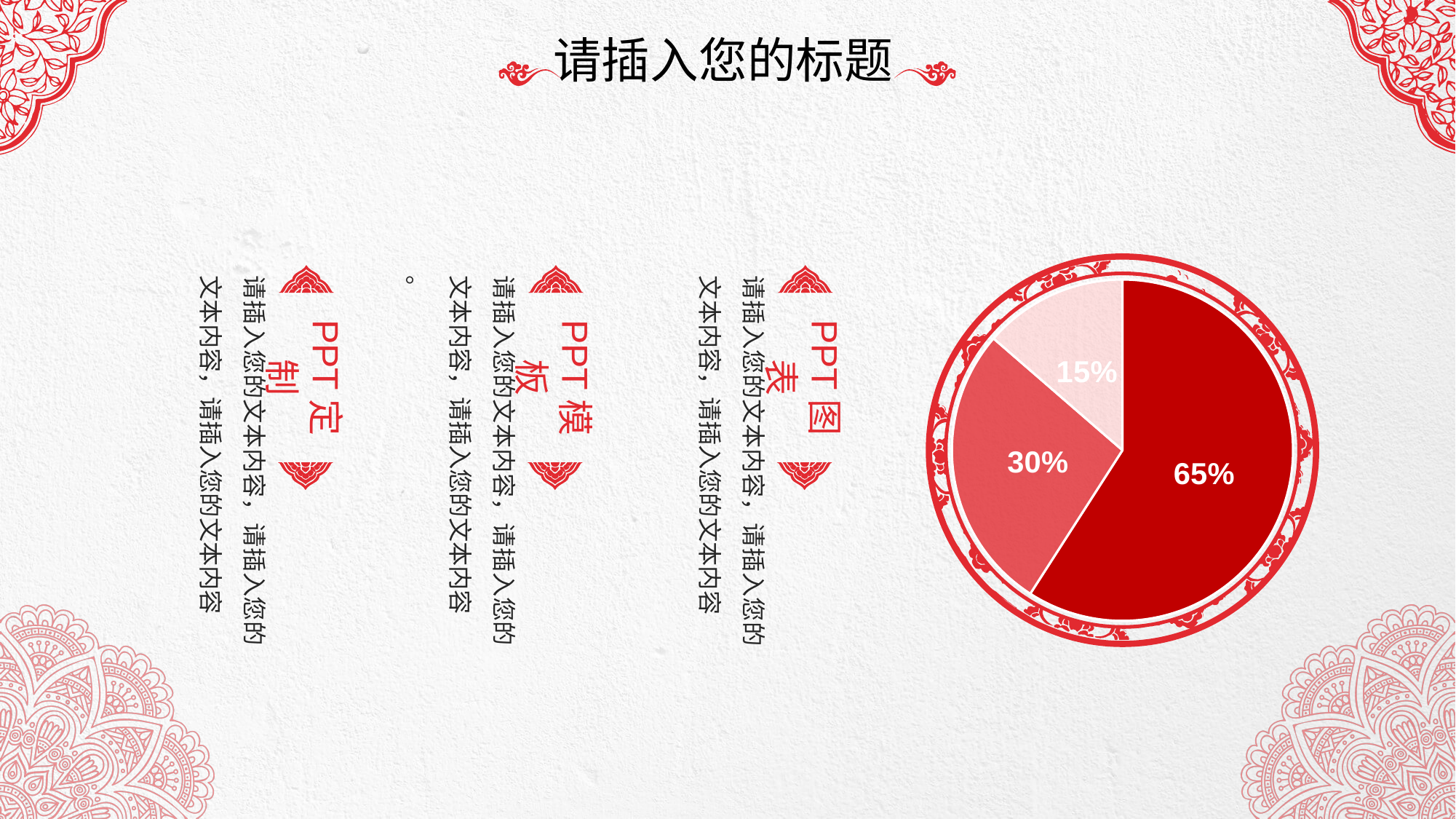
How many slices does the pie chart have? 3 What is the largest value labelled on the pie chart? 65% What value is labelled on the lightest pink slice of the pie chart? 15% What is the smallest value labelled on the pie chart? 15% Is the value of the dark red slice greater or less than 50%? greater What is the difference between the largest and smallest labelled values on the pie chart? 50 percentage points What value is labelled on the dark red slice of the pie chart? 65% Does the pie chart have a legend? No What kind of chart is shown on the slide? pie chart What is the difference between the 65% slice and the 30% slice? 35 percentage points What value is labelled on the medium red slice of the pie chart? 30% Which slice is larger, the dark red slice or the medium red slice? the dark red slice